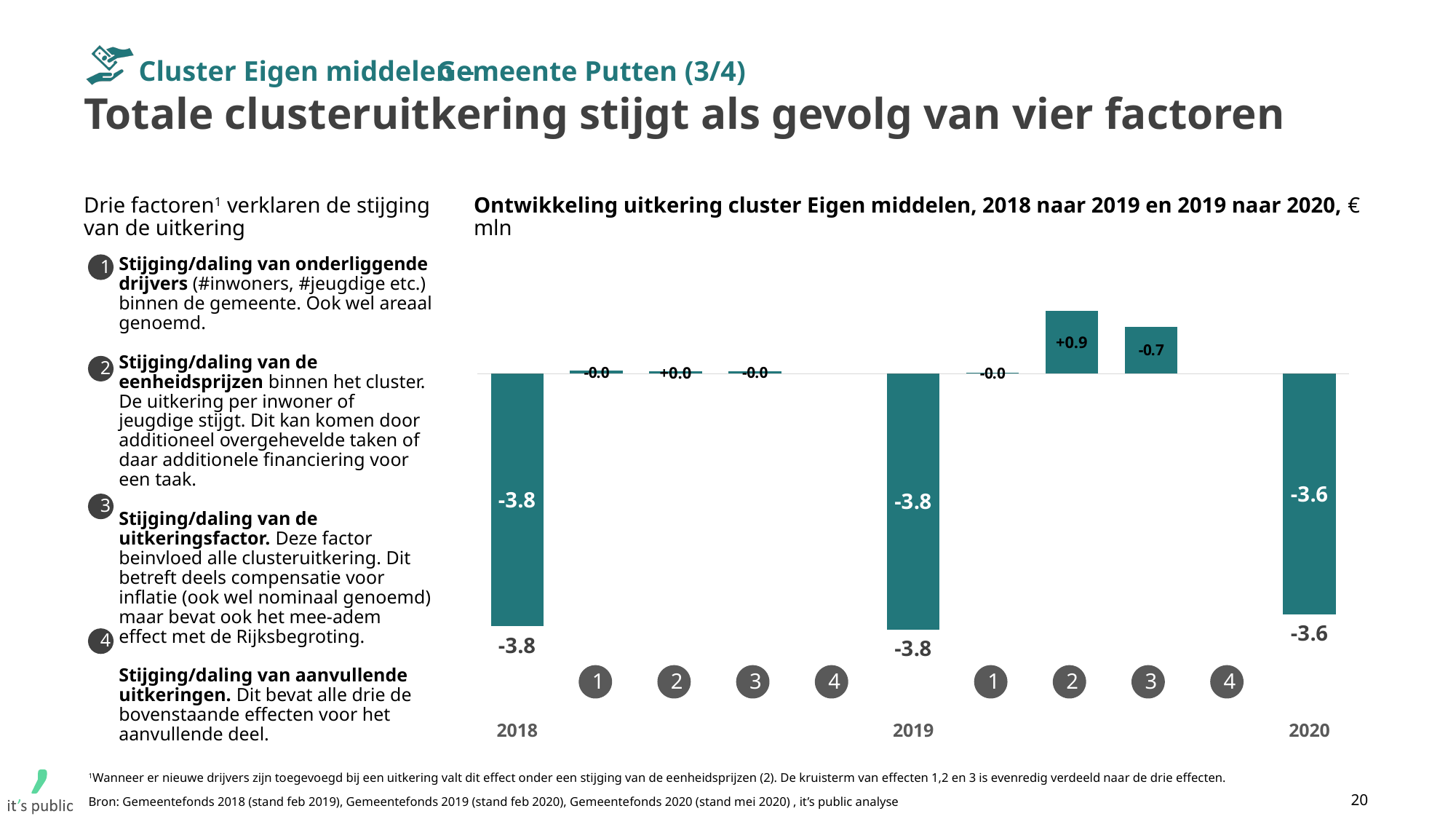
How many year totals (2018, 2019, 2020) are shown in the chart? 3 What is the value shown for 2019 in the chart? -3.8 What is the value shown for 2018 in the chart? -3.8 Does the total cluster payment rise or fall from 2018 to 2020? Rises What is the value of factor 2 in the step from 2018 to 2019? +0.0 What is the value of factor 2 in the step from 2019 to 2020? +0.9 What is the value of factor 3 in the step from 2019 to 2020? -0.7 What is the value shown for 2020 in the chart? -3.6 What is the difference between the 2018 value and the 2020 value? 0.2 Which factor in the step from 2019 to 2020 has the largest positive effect? Factor 2 What kind of chart is shown on the slide? Bar chart Which factor in the step from 2019 to 2020 has the most negative effect? Factor 3